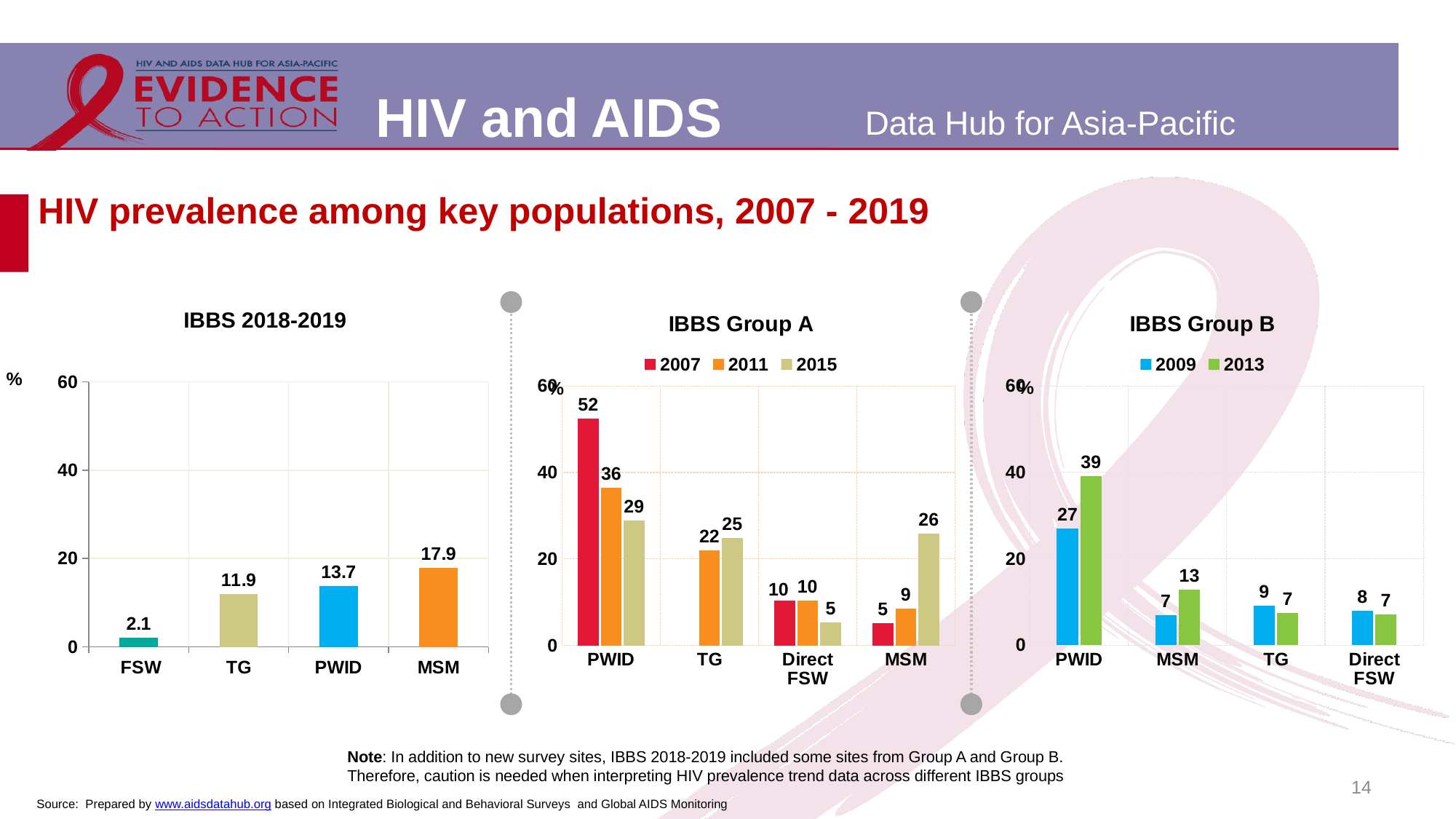
In the IBBS 2018-2019 chart, what is the value for MSM? 17.9 In the IBBS Group B chart, which category has the highest 2013 value? PWID In the IBBS Group B chart, what is the 2013 value for PWID? 39 In the IBBS 2018-2019 chart, how many categories are shown? 4 In the IBBS Group B chart, which is larger for TG: the 2009 value or the 2013 value? 2009 What kind of chart is the IBBS Group B chart? bar chart In the IBBS 2018-2019 chart, what is the difference between the PWID and TG values? 1.8 In the IBBS Group A chart, what is the 2007 value for PWID? 52 In the IBBS Group A chart, do the PWID values rise or fall from 2007 to 2015? fall In the IBBS 2018-2019 chart, which category has the lowest value? FSW In the IBBS Group A chart, how many series does the legend list? 3 In the IBBS Group A chart, what is the difference between the 2015 and 2011 values for MSM? 17